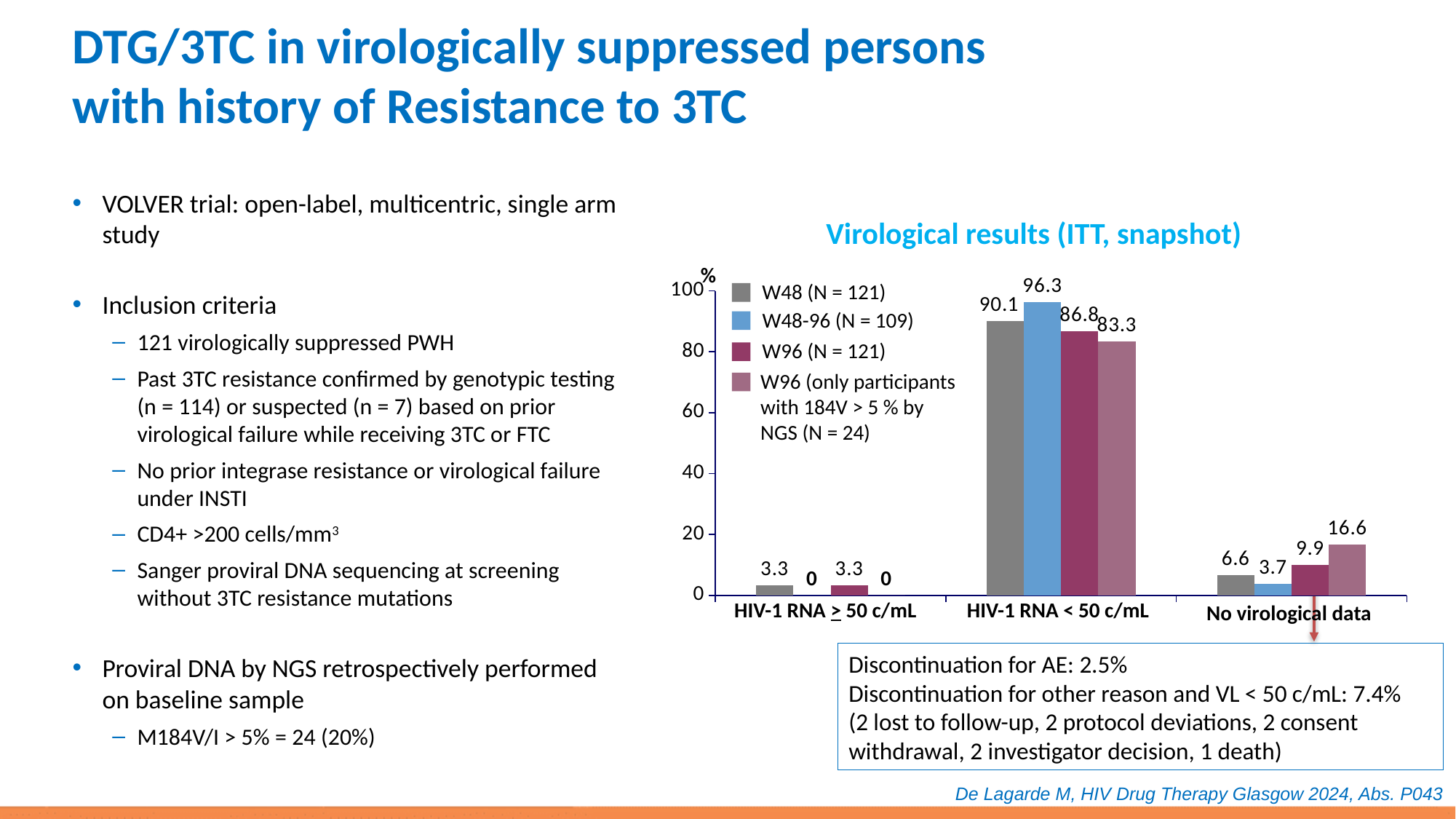
What type of chart is shown on the slide? Bar chart How many categories are shown on the x axis? 3 How many series does the legend list? 4 What is the W48-96 (N = 109) value for HIV-1 RNA ≥ 50 c/mL? 0 What is the W96 (only participants with 184V > 5 % by NGS, N = 24) value for No virological data? 16.6 Which is larger for No virological data: the W96 (N = 121) value or the W48 (N = 121) value? W96 (N = 121) What is the W48-96 (N = 109) value for HIV-1 RNA < 50 c/mL? 96.3 Which series has the highest value for HIV-1 RNA < 50 c/mL? W48-96 (N = 109) Which series has the lowest value for No virological data? W48-96 (N = 109) What is the difference between the W48-96 and W48 values for HIV-1 RNA < 50 c/mL? 6.2 Is the W96 (N = 121) value for HIV-1 RNA < 50 c/mL greater or less than 80? greater What is the W48 (N = 121) value for HIV-1 RNA < 50 c/mL? 90.1